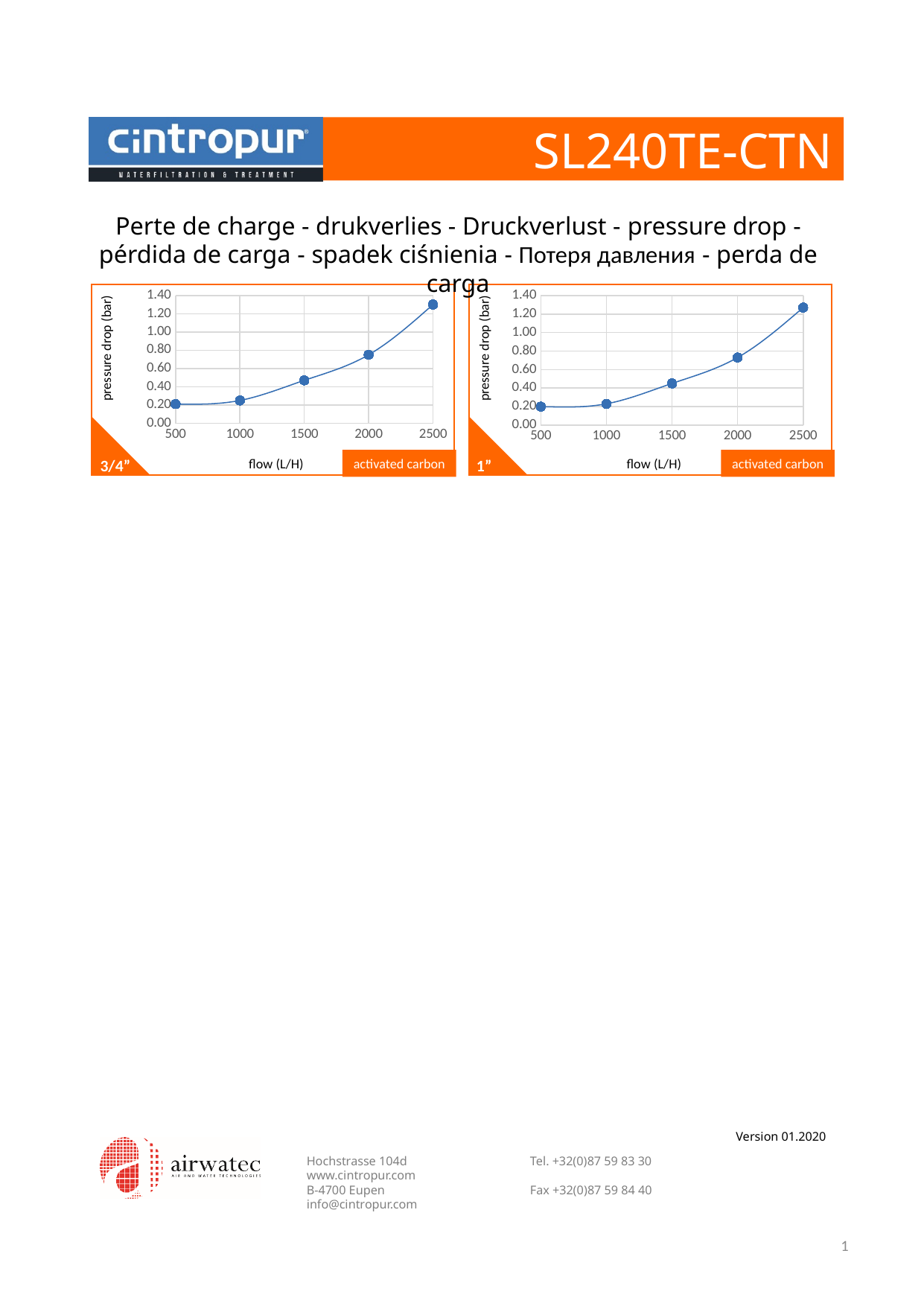
On the right chart (1"), at which flow value is the pressure drop lowest? 500 On the right chart (1"), does the pressure drop rise or fall as flow increases? rise On the right chart (1"), is the pressure drop at a flow of 1500 L/H greater or less than 0.60 bar? less On the left chart (3/4"), at which flow value is the pressure drop highest? 2500 How many data points are plotted on the left chart (3/4")? 5 What is the y-axis label on the left chart (3/4")? pressure drop (bar) On the right chart (1"), which has the larger pressure drop: a flow of 1000 L/H or a flow of 2000 L/H? 2000 L/H On the left chart (3/4"), is the pressure drop at a flow of 2500 L/H greater or less than 1.00 bar? greater What kind of chart is the left chart (3/4")? line chart On the left chart (3/4"), does the pressure drop rise or fall as flow increases? rise On the left chart (3/4"), is the pressure drop at a flow of 2000 L/H greater or less than 0.60 bar? greater How many data points are plotted on the right chart (1")? 5